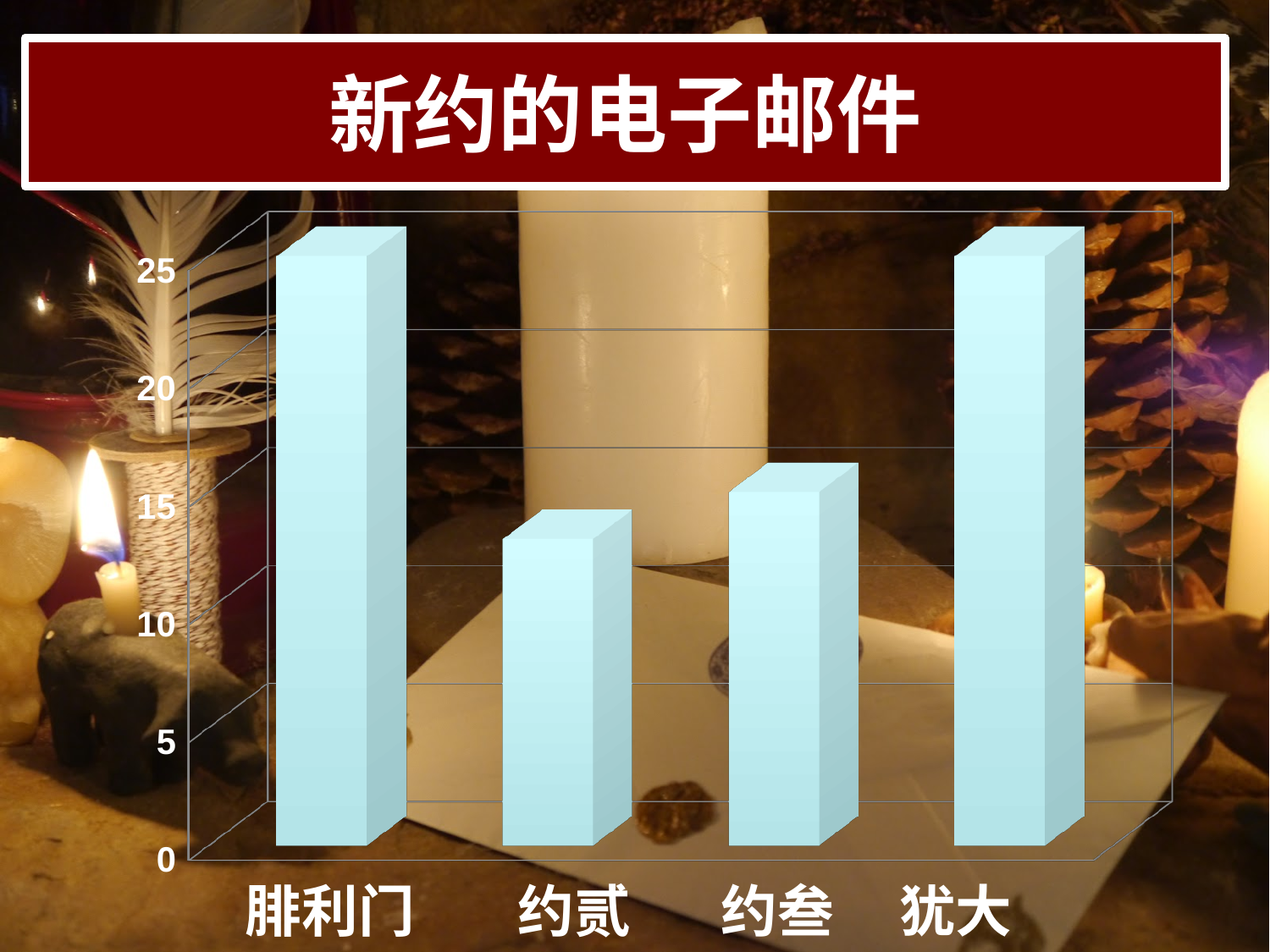
Which category has the lowest bar in the chart? 约贰 Which is larger, the value for 约贰 or the value for 约叁? 约叁 How many categories are shown on the x axis of the chart? 4 Is the value for 约贰 greater or less than 10? greater What is the highest value labelled on the vertical axis of the chart? 25 Is the value for 犹大 greater or less than 20? greater Is the value for 约贰 greater or less than 15? less What is the title of the chart? 新约的电子邮件 What kind of chart is shown on the slide? bar chart